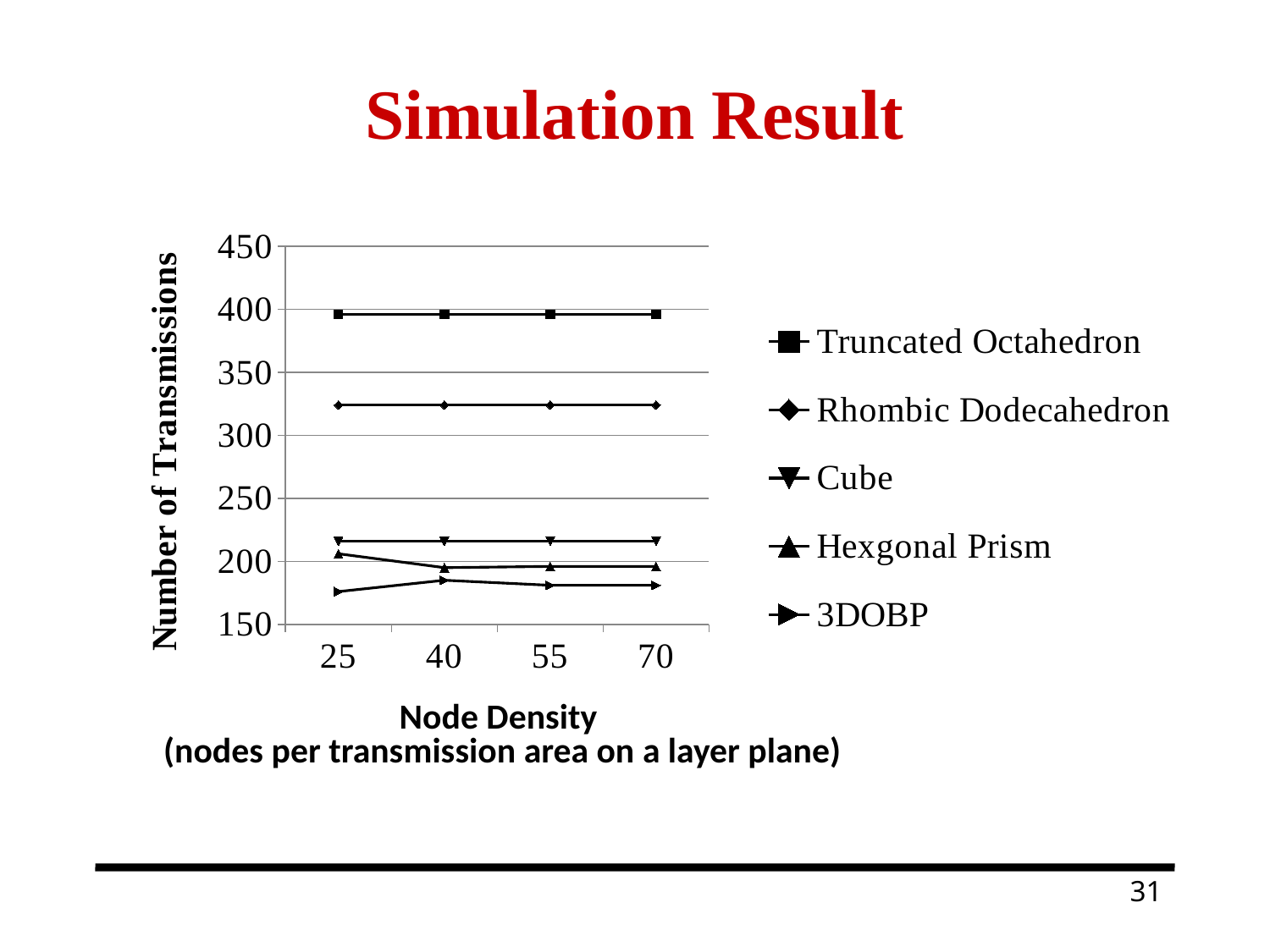
Is the value for Rhombic Dodecahedron at node density 40 greater or less than 300? greater Does the Truncated Octahedron line rise, fall, or stay flat as node density increases? stays flat How many node density values are plotted along the x axis? 4 Which series has the lowest number of transmissions at node density 70? 3DOBP Is the value for 3DOBP at node density 25 greater or less than 200? less Which series has the highest number of transmissions across all node densities? Truncated Octahedron How many series does the legend list? 5 What is the label of the y axis? Number of Transmissions What kind of chart is shown on the slide? line chart Is the value for Cube at node density 55 greater or less than 250? less At node density 70, which series has more transmissions, Cube or Hexgonal Prism? Cube